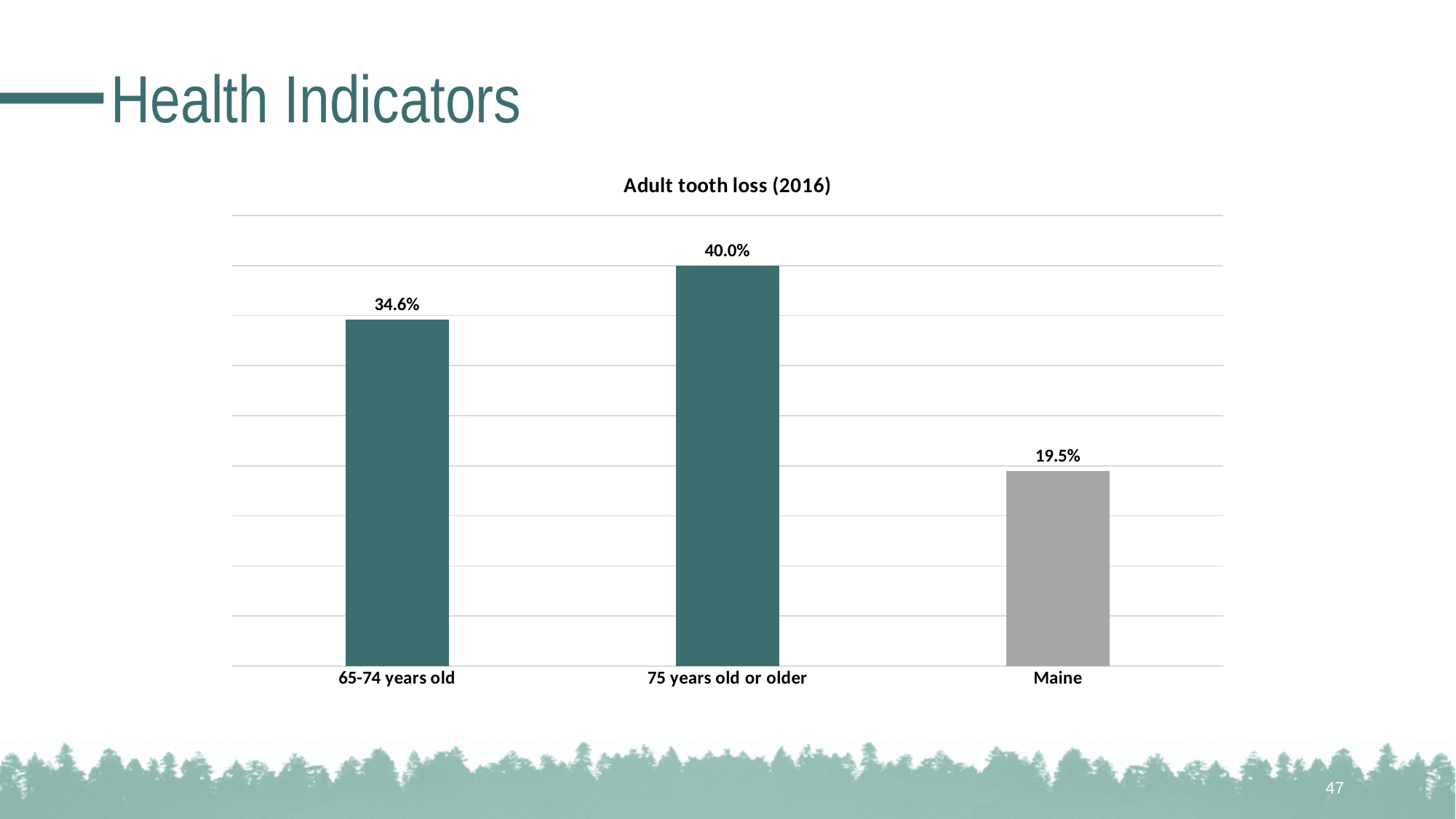
What kind of chart is shown on the slide? Bar chart Which category has the lowest value? Maine Which is larger, the value for 65-74 years old or the value for Maine? 65-74 years old What is the value for Maine? 19.5% What is the value for 65-74 years old? 34.6% What is the value for 75 years old or older? 40.0% What is the difference between the values for 75 years old or older and 65-74 years old? 5.4% How many categories are shown in the chart? 3 What is the difference between the values for 65-74 years old and Maine? 15.1% What is the title of the chart? Adult tooth loss (2016) Which category's bar is coloured grey rather than teal? Maine Which category has the highest value? 75 years old or older